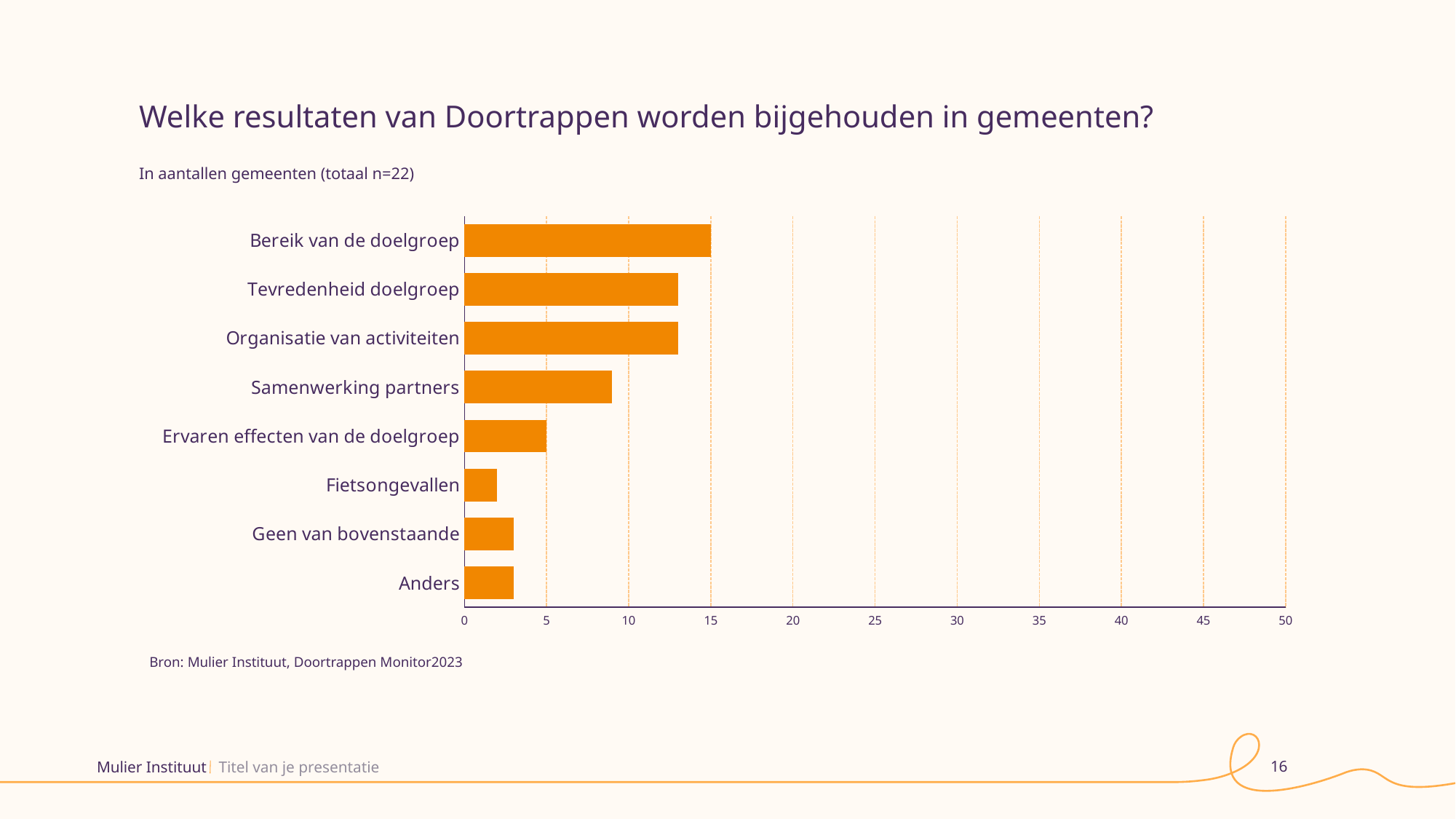
Is the value for Tevredenheid doelgroep greater or less than 10? greater What is the title of the chart on the slide? Welke resultaten van Doortrappen worden bijgehouden in gemeenten? Which category has the lowest value? Fietsongevallen What is the difference between the values for Bereik van de doelgroep and Ervaren effecten van de doelgroep? 10 Is the value for Samenwerking partners greater or less than 10? less Is the value for Organisatie van activiteiten greater or less than 15? less What is the value for Ervaren effecten van de doelgroep? 5 Which category has the highest value? Bereik van de doelgroep Which is larger, the value for Bereik van de doelgroep or the value for Samenwerking partners? Bereik van de doelgroep What is the value for Bereik van de doelgroep? 15 What type of chart is shown on the slide? bar chart How many categories are shown in the chart? 8